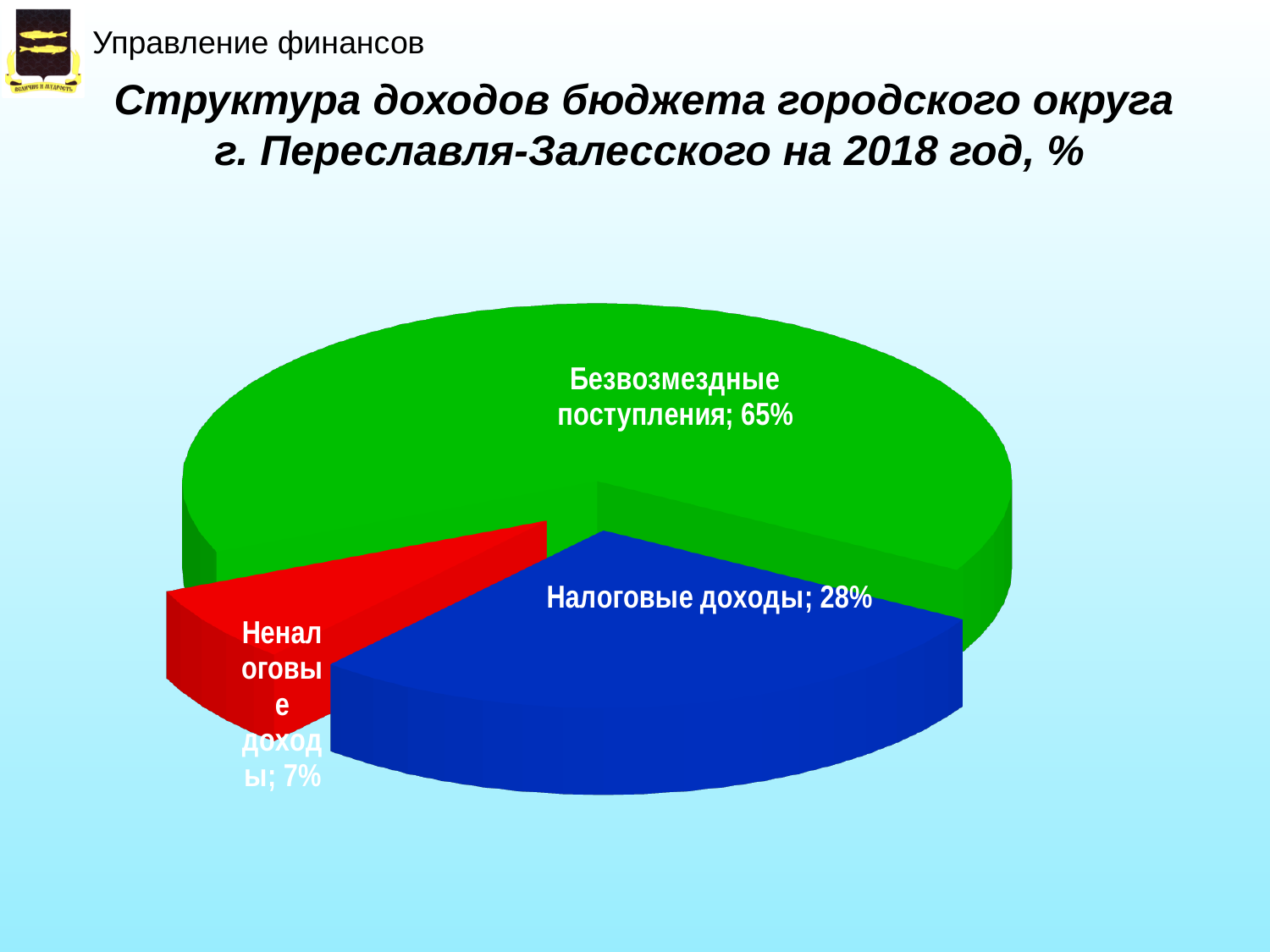
What share of the budget revenue is Налоговые доходы? 28% What share of the budget revenue is Безвозмездные поступления? 65% Which is larger, Налоговые доходы or Неналоговые доходы? Налоговые доходы Which category has the smallest share of the pie? Неналоговые доходы What is the difference in percentage points between Безвозмездные поступления and Налоговые доходы? 37 What year does the chart title refer to? 2018 What is the difference in percentage points between Налоговые доходы and Неналоговые доходы? 21 What share of the budget revenue is Неналоговые доходы? 7% How many slices does the pie chart have? 3 Which category has the largest share of the pie? Безвозмездные поступления What colour is the slice for Налоговые доходы? blue What kind of chart is shown on the slide? pie chart